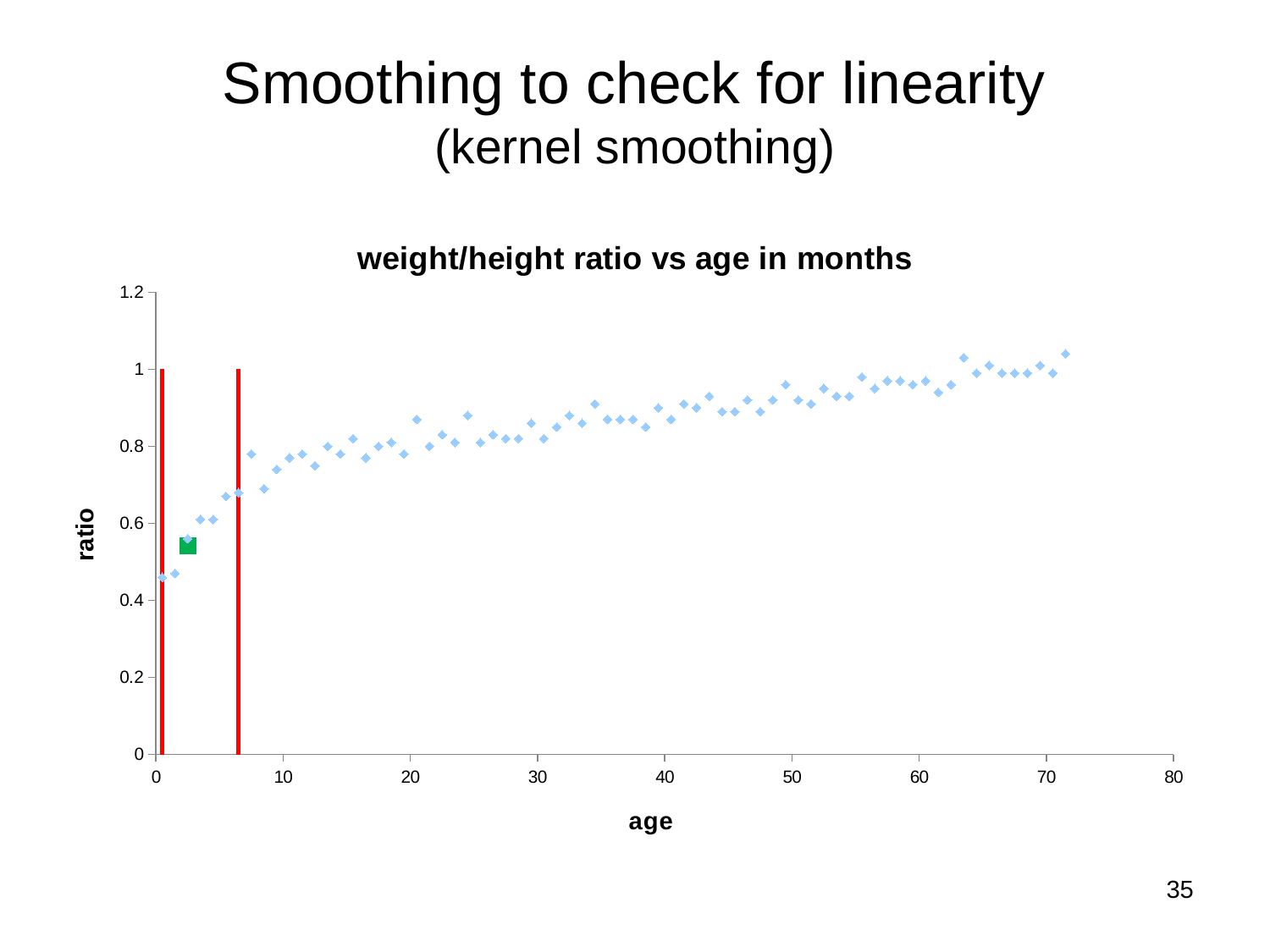
Is the ratio for the youngest age (near 0 months) greater or less than 0.6? less What is the highest value shown on the horizontal axis? 80 Do the ratio values generally rise or fall as age increases? rise Is the ratio at around age 40 months greater or less than 0.6? greater What kind of chart is shown on the slide? scatter plot What is the title of the chart? weight/height ratio vs age in months Is the ratio at around age 70 months greater or less than 0.8? greater Which has the larger ratio: the point near age 10 months or the point near age 70 months? age 70 months What is the highest value shown on the vertical axis? 1.2 What is the label on the vertical axis of the chart? ratio